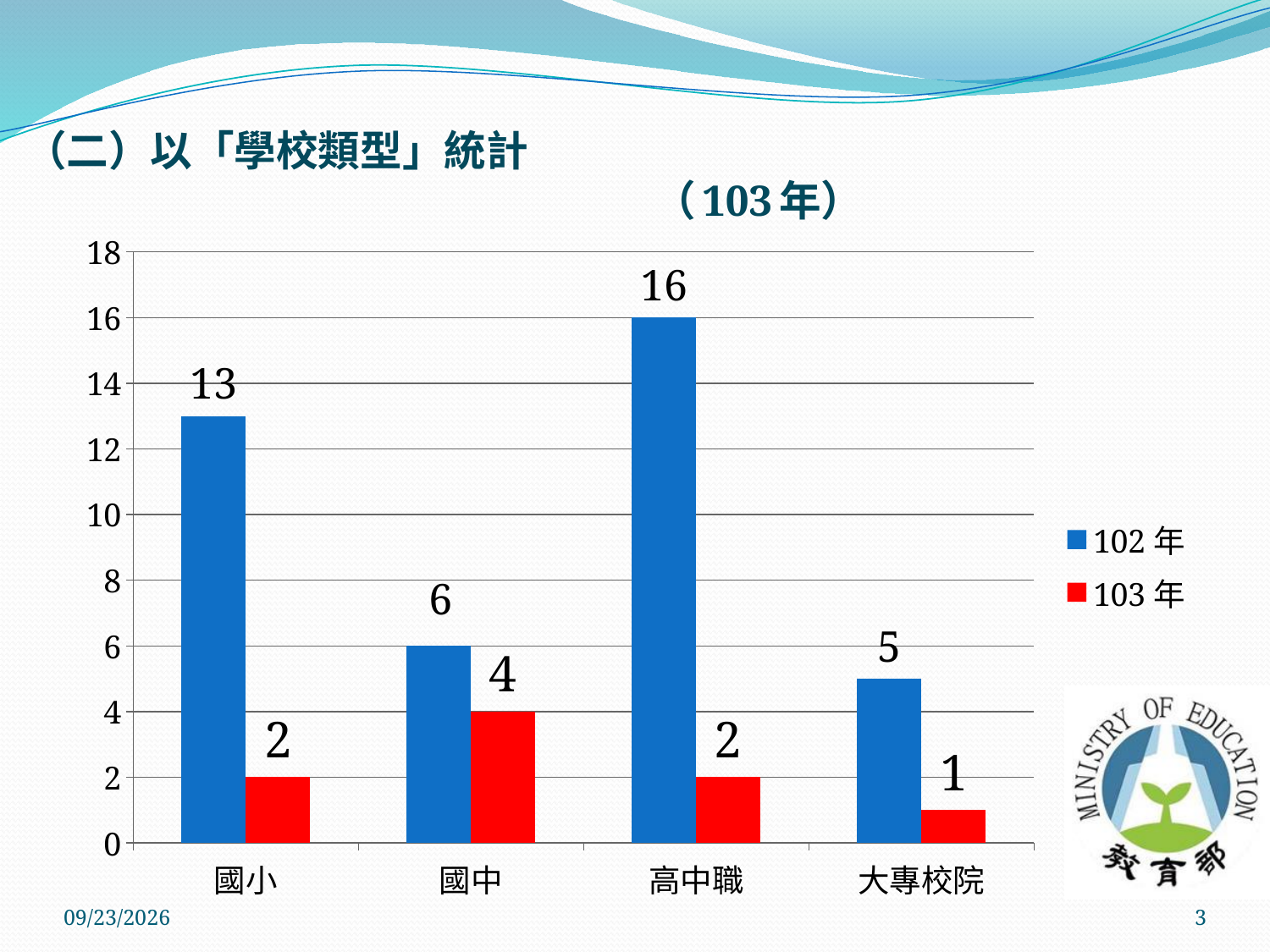
Is the value for 國小 in the 102 年 series greater or less than 10? greater What colour represents the 103 年 series? red What is the value for 大專校院 in the 103 年 series? 1 What kind of chart is shown on the slide? bar chart What is the value for 國小 in the 102 年 series? 13 How many categories are shown on the x axis? 4 What is the difference between the 102 年 and 103 年 values for 高中職? 14 Which category has the lowest value in the 103 年 series? 大專校院 How many series does the legend list? 2 Which is larger for 國中: the 102 年 value or the 103 年 value? 102 年 What is the value for 國中 in the 103 年 series? 4 Which category has the highest value in the 102 年 series? 高中職